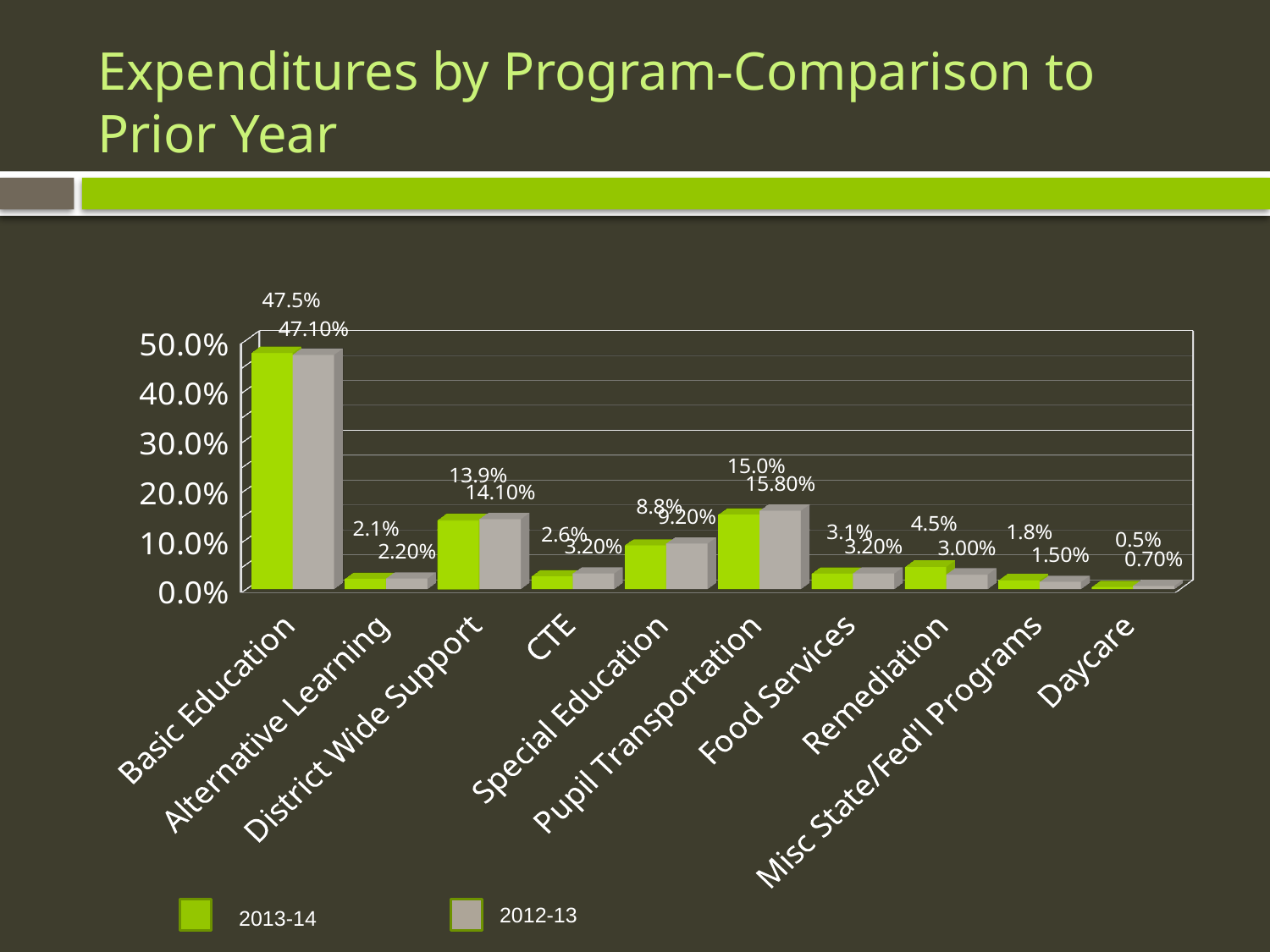
What is the 2013-14 value for Remediation? 4.5% For CTE, which year has the larger value, 2013-14 or 2012-13? 2012-13 Which program has the highest 2013-14 expenditure share? Basic Education What is the 2012-13 value for Daycare? 0.70% Which program has the lowest 2012-13 expenditure share? Daycare What is the 2012-13 value for Pupil Transportation? 15.80% How many series does the legend list? 2 What is the difference between the 2013-14 and 2012-13 values for Remediation? 1.5% How many programs are shown on the x axis? 10 What is the 2013-14 value for Basic Education? 47.5% Is the 2013-14 value for District Wide Support greater or less than 10.0%? greater What kind of chart is shown on the slide? Bar chart